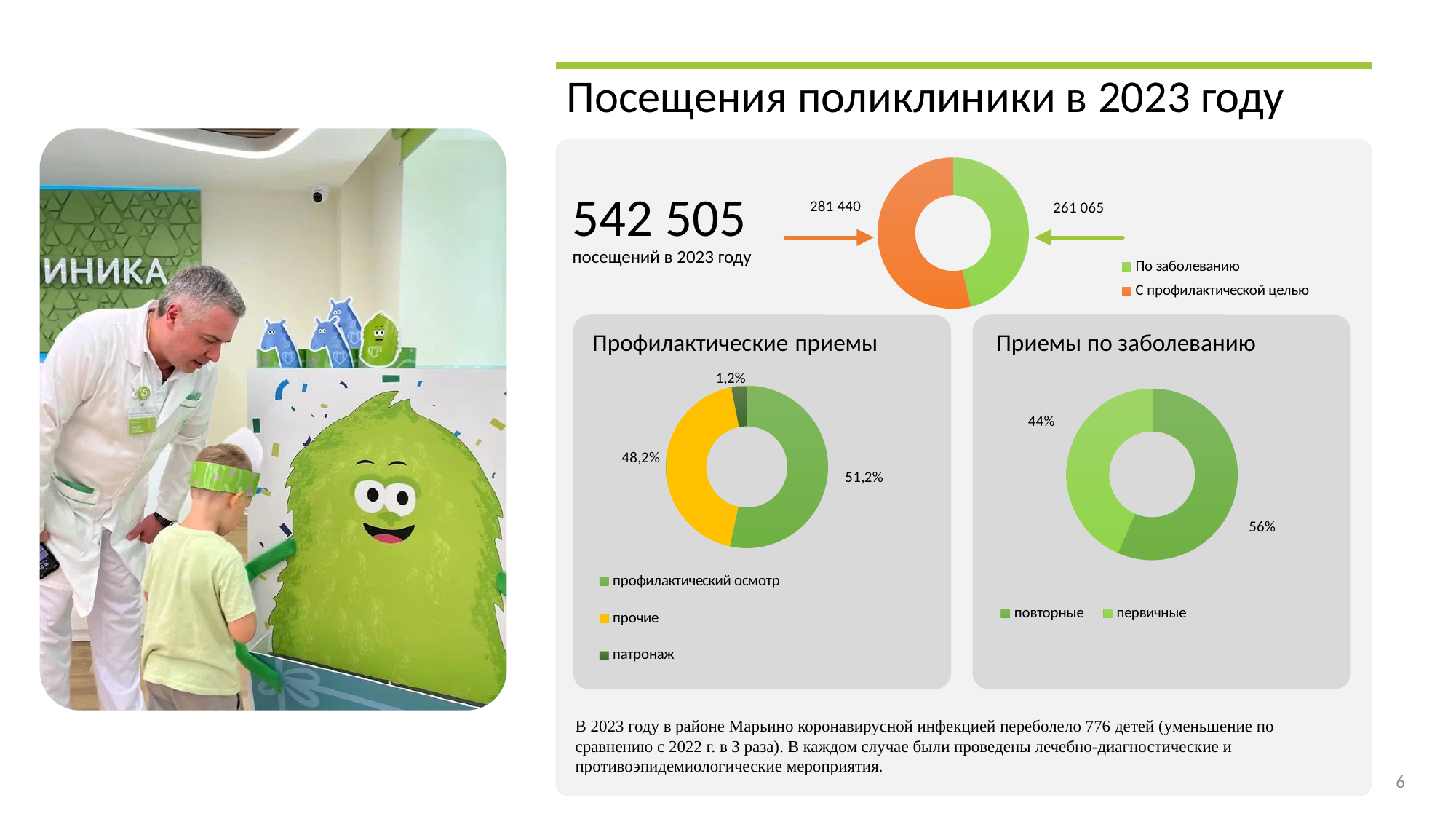
In the 'Профилактические приемы' chart, which category has the smallest share? патронаж What kind of chart is the 'Приемы по заболеванию' chart? Donut (pie) chart On the top donut chart, what is the value for 'С профилактической целью'? 281 440 How many series does the legend of the top donut chart list? 2 In the 'Профилактические приемы' chart, what share is 'профилактический осмотр'? 51,2% In the 'Профилактические приемы' chart, what share is 'патронаж'? 1,2% How many categories does the 'Профилактические приемы' chart show? 3 On the top donut chart, what is the value for 'По заболеванию'? 261 065 On the top donut chart, which category has the larger value, 'По заболеванию' or 'С профилактической целью'? С профилактической целью In the 'Приемы по заболеванию' chart, what is the difference between 'повторные' and 'первичные'? 12% In the 'Приемы по заболеванию' chart, what share is 'повторные'? 56% On the top donut chart, what is the difference between 'С профилактической целью' and 'По заболеванию'? 20 375